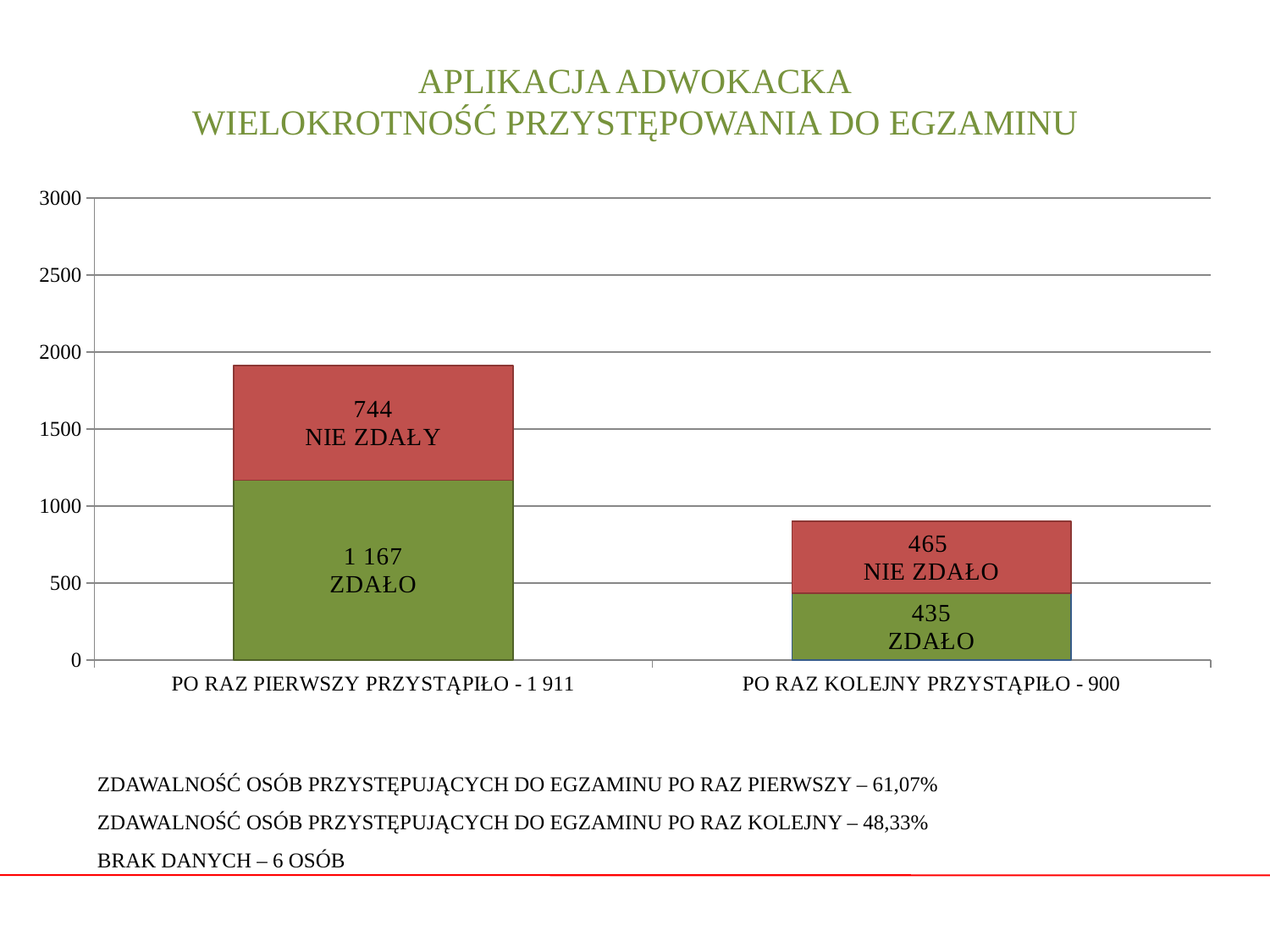
How many people passed (ZDAŁO) among those taking the exam for the first time (PO RAZ PIERWSZY PRZYSTĄPIŁO)? 1 167 How many categories are shown on the x axis of the chart? 2 What is the total height of the stacked bar for PO RAZ PIERWSZY PRZYSTĄPIŁO? 1 911 How many people did not pass (NIE ZDAŁY) among those taking the exam for the first time? 744 How many people passed (ZDAŁO) among those taking the exam again (PO RAZ KOLEJNY PRZYSTĄPIŁO)? 435 What type of chart is shown on the slide? Stacked bar chart What is the total height of the stacked bar for PO RAZ KOLEJNY PRZYSTĄPIŁO? 900 How many people did not pass (NIE ZDAŁO) among those taking the exam again? 465 Which category has the higher total number of candidates? PO RAZ PIERWSZY PRZYSTĄPIŁO What is the difference between the number who passed and the number who did not pass among first-time candidates? 423 Among candidates taking the exam again, which is larger: the number who passed or the number who did not pass? NIE ZDAŁO (465) Is the total for PO RAZ KOLEJNY PRZYSTĄPIŁO greater or less than 1000? less